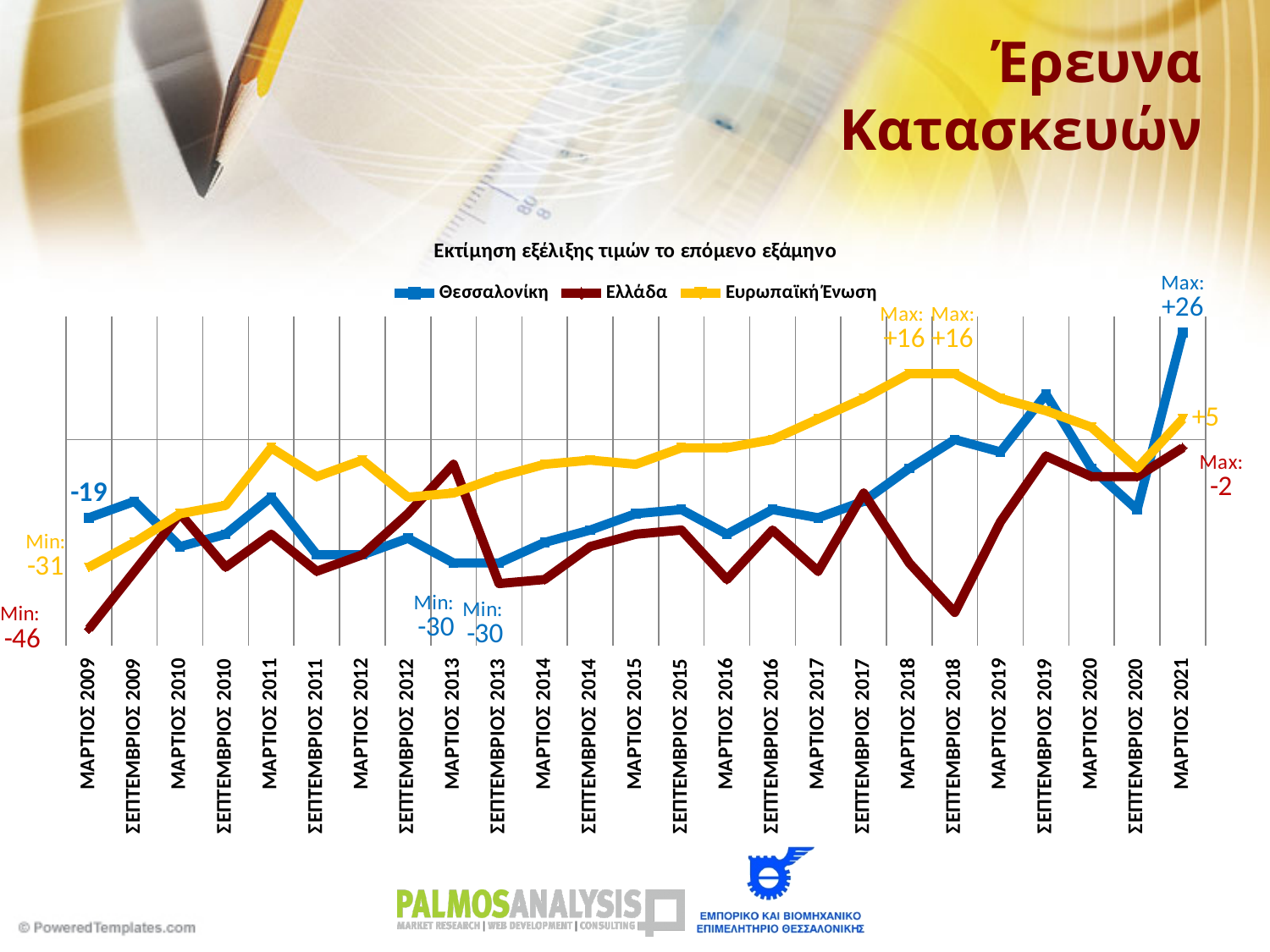
What is the difference between the Θεσσαλονίκη and Ευρωπαϊκή Ένωση values in ΜΑΡΤΙΟΣ 2021? 21 What is the title of the chart? Εκτίμηση εξέλιξης τιμών το επόμενο εξάμηνο What is the value for Θεσσαλονίκη in ΜΑΡΤΙΟΣ 2009? -19 How many series does the legend list? 3 What is the value for Ελλάδα in ΜΑΡΤΙΟΣ 2021? -2 What is the minimum value labelled for Ελλάδα? -46 Which series has the highest value in ΜΑΡΤΙΟΣ 2021? Θεσσαλονίκη What is the minimum value labelled for Ευρωπαϊκή Ένωση? -31 What is the value for Ευρωπαϊκή Ένωση in ΜΑΡΤΙΟΣ 2021? +5 What kind of chart is shown on the slide? Line chart What is the maximum value labelled for Θεσσαλονίκη? +26 How many time points are shown on the x axis? 25